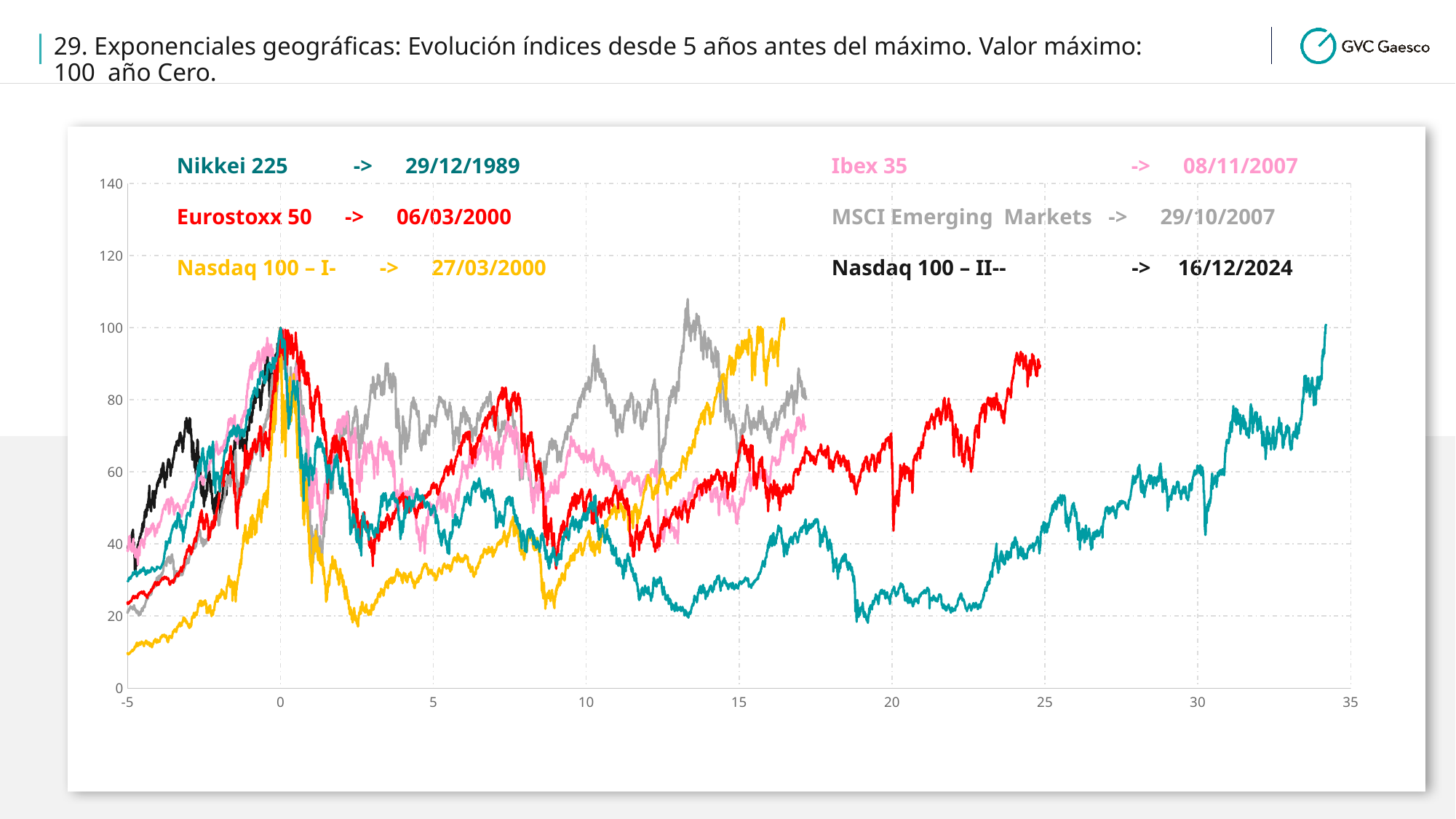
Which series reaches the highest value on the chart after year 0? MSCI Emerging Markets Is the value for Eurostoxx 50 at year 24 greater or less than 80? greater What date is shown next to Nikkei 225 in the legend? 29/12/1989 Is the value for Nikkei 225 at year 20 greater or less than 40? less What date is shown next to Nasdaq 100 – II-- in the legend? 16/12/2024 What type of chart is shown on the slide? Line chart At year 10, which is higher: Eurostoxx 50 or MSCI Emerging Markets? MSCI Emerging Markets What value do all the indices take at year 0 on the chart? 100 How many series does the chart's legend list? 6 Does the Nikkei 225 line rise or fall between year 25 and year 34? Rise Is the value for Nasdaq 100 – I- at year -5 greater or less than 20? less